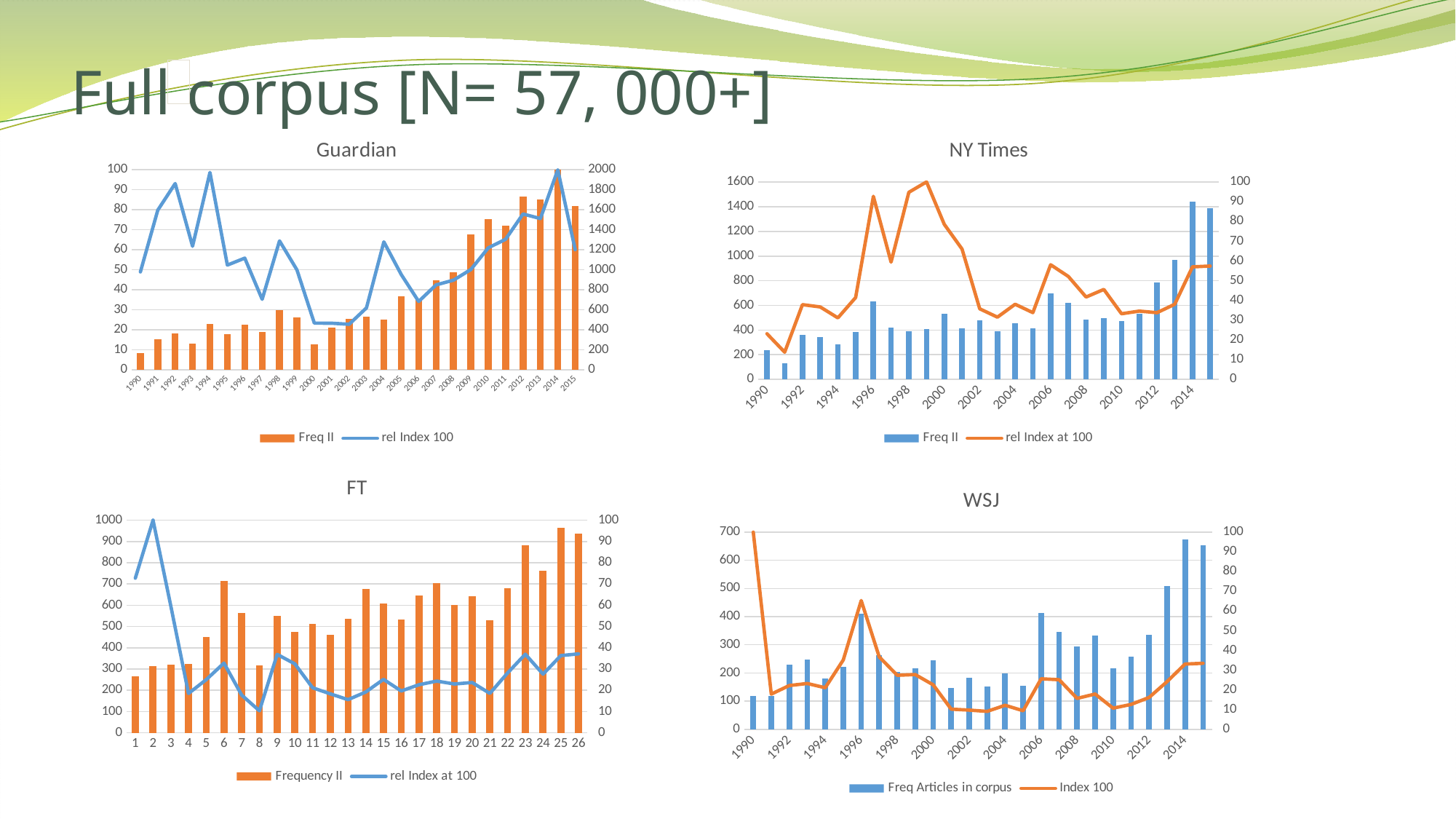
In the NY Times chart, is the Freq II value for 2006 greater or less than 600? greater In the FT chart, which has the larger Frequency II bar, category 6 or category 7? 6 What are the two legend entries in the WSJ chart? Freq Articles in corpus and Index 100 In the FT chart, at which category does the rel Index at 100 line reach its peak? 2 In the WSJ chart, is the Freq Articles in corpus value for 2014 greater or less than 600? greater What kind of chart is the Guardian chart? A combined bar and line chart In the Guardian chart, do the Freq II bars generally rise or fall from 2005 to 2014? rise In the FT chart, which category has the highest Frequency II bar? 25 In the FT chart, which category has the lowest Frequency II bar? 1 How many categories are shown on the x axis of the FT chart? 26 How many series does the legend of the NY Times chart list? 2 In the NY Times chart, which year has the highest Freq II bar? 2014